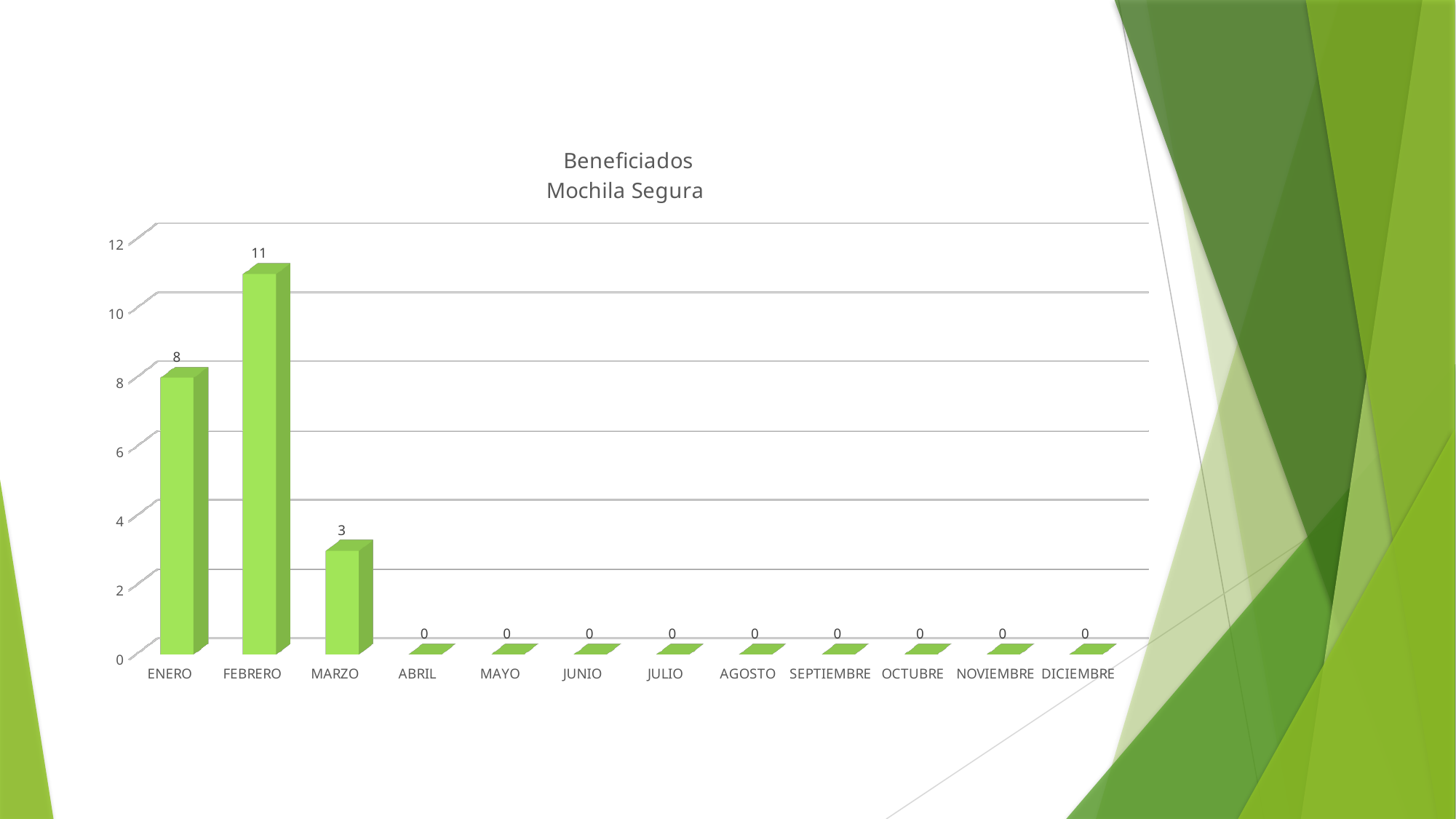
Which month has the highest value? FEBRERO What is the difference between the values for FEBRERO and ENERO? 3 What is the value for FEBRERO? 11 What is the difference between the values for ENERO and MARZO? 5 What kind of chart is shown on the slide? Bar chart What is the title of the chart? Beneficiados Mochila Segura How many months are shown on the x axis? 12 What is the value for ABRIL? 0 Is the value for FEBRERO greater or less than 10? greater What is the value for MARZO? 3 What is the value for ENERO? 8 Which is larger, the value for ENERO or the value for MARZO? ENERO